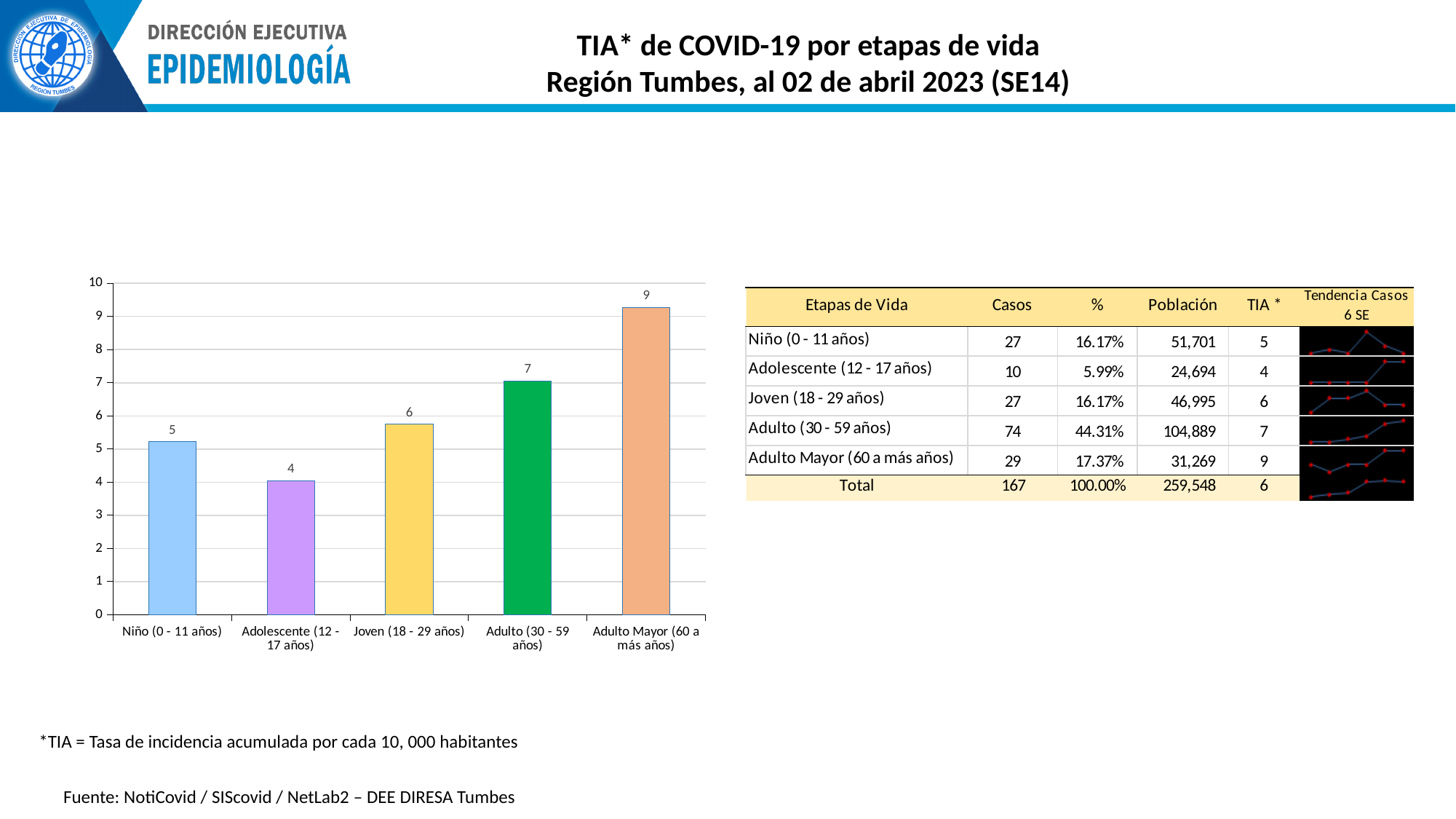
What is the value shown for Niño (0 - 11 años) in the bar chart? 5 Which is larger in the bar chart: the value for Joven (18 - 29 años) or the value for Niño (0 - 11 años)? Joven (18 - 29 años) What is the maximum value shown on the y axis of the bar chart? 10 What is the value shown for Adulto Mayor (60 a más años) in the bar chart? 9 What is the difference between the labelled values for Adulto Mayor (60 a más años) and Adolescente (12 - 17 años)? 5 What kind of chart is shown on the left of the slide? Bar chart Which category has the lowest bar in the chart? Adolescente (12 - 17 años) Is the bar for Adulto (30 - 59 años) greater or less than 6? greater What is the value shown for Adulto (30 - 59 años) in the bar chart? 7 Which category has the highest bar in the chart? Adulto Mayor (60 a más años) How many categories are shown on the x axis of the bar chart? 5 What colour is the bar for Adulto (30 - 59 años)? Green